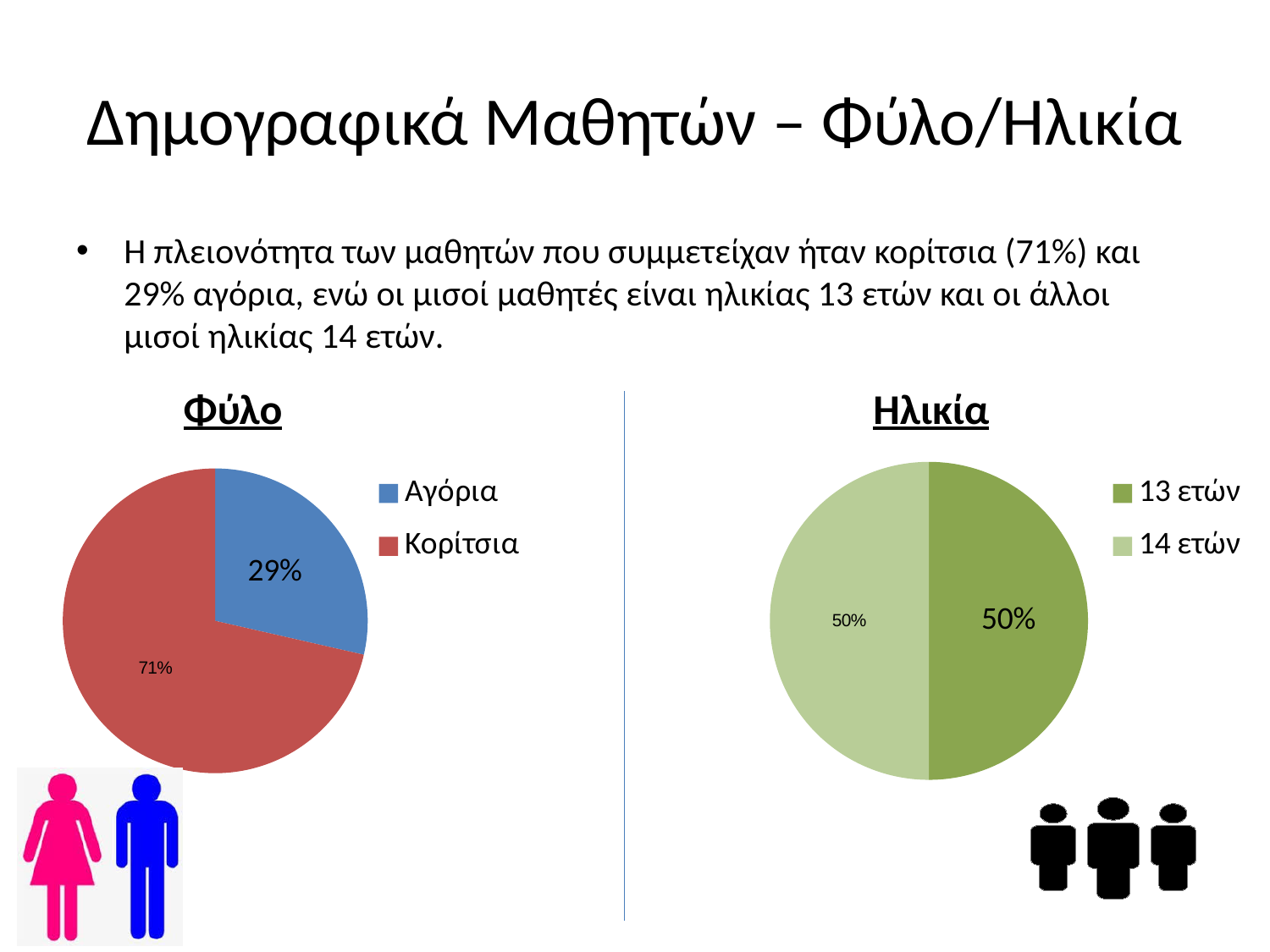
In the Φύλο chart, what percentage is shown for Αγόρια? 29% In the Φύλο chart, what colour is the Αγόρια slice? Blue In the Ηλικία chart, what percentage is shown for 14 ετών? 50% In the Φύλο chart, what is the difference in percentage points between Κορίτσια and Αγόρια? 42 In the Ηλικία chart, what percentage is shown for 13 ετών? 50% In the Ηλικία chart, how many entries does the legend list? 2 In the Φύλο chart, what kind of chart is used? Pie chart In the Φύλο chart, how many slices does the pie have? 2 In the Ηλικία chart, what kind of chart is used? Pie chart In the Φύλο chart, what percentage is shown for Κορίτσια? 71% In the Φύλο chart, which category has the larger share? Κορίτσια In the Φύλο chart, which category has the smaller share? Αγόρια